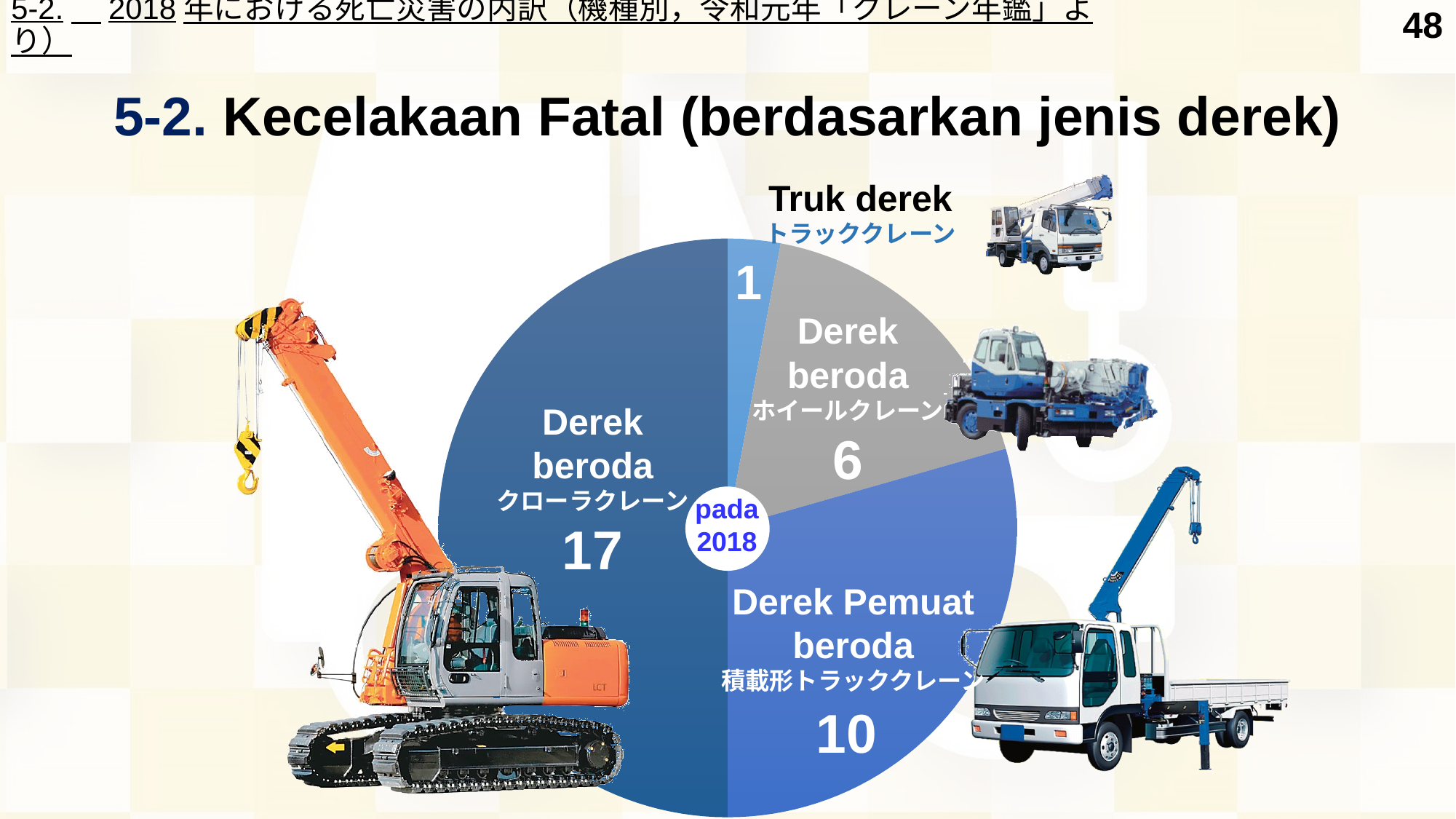
What is the value for Derek Pemuat beroda (積載形トラッククレーン) in the pie chart? 10 What is the value for Derek beroda (ホイールクレーン) in the pie chart? 6 How many slices does the pie chart have? 4 Which is larger: the value for Derek beroda (ホイールクレーン) or Derek Pemuat beroda? Derek Pemuat beroda What share of the pie does the Derek beroda (クローラクレーン) slice represent? 50% What is the difference between the values for Derek beroda (クローラクレーン) and Derek Pemuat beroda? 7 What is the value for Derek beroda (クローラクレーン) in the pie chart? 17 Which crane type has the largest slice in the pie chart? Derek beroda (クローラクレーン) What is the value for Truk derek (トラッククレーン) in the pie chart? 1 Which crane type has the smallest slice in the pie chart? Truk derek (トラッククレーン) What is the total of all slices in the pie chart? 34 What kind of chart is shown on the slide? pie chart